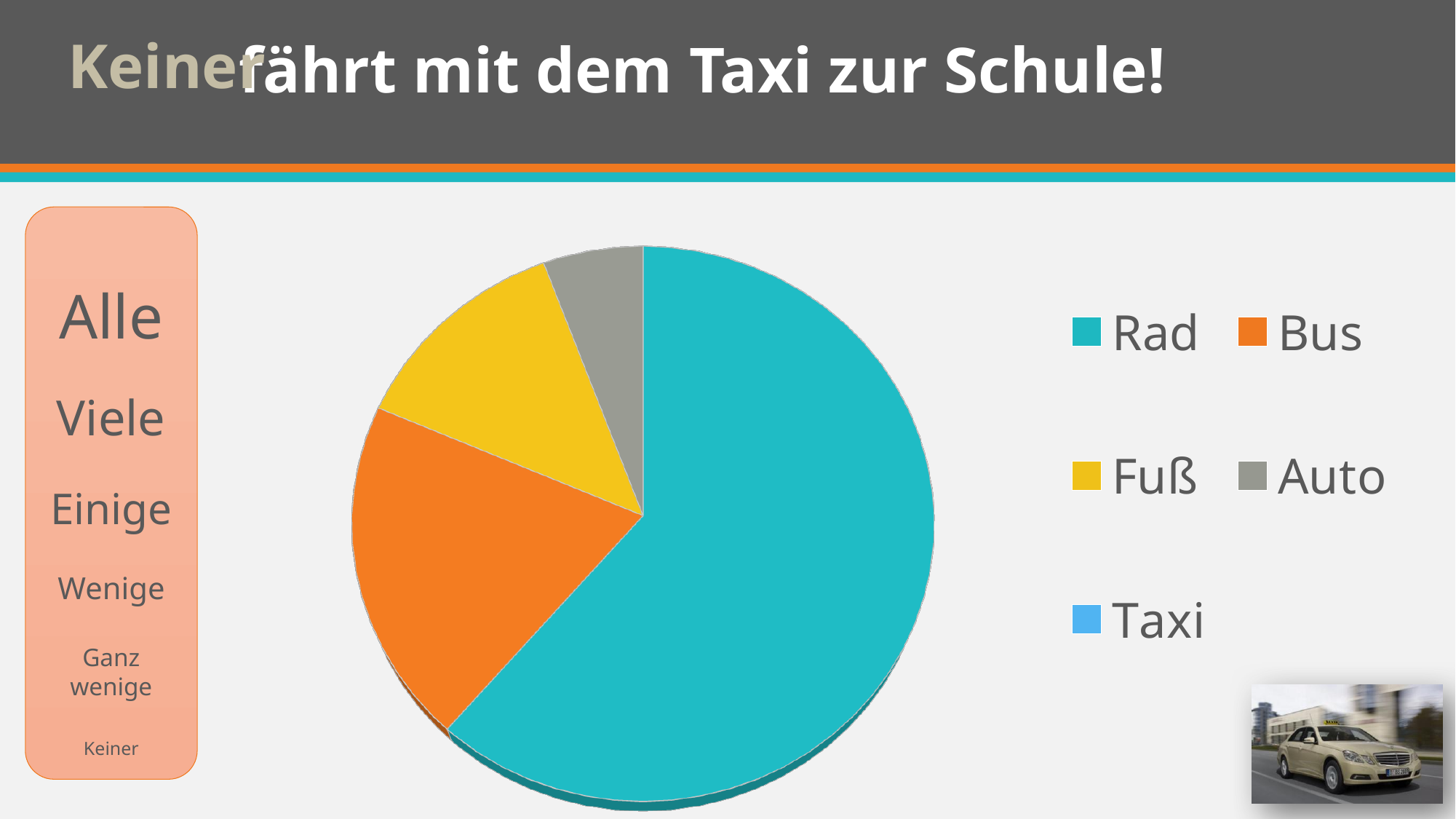
Does the Rad slice take up more or less than half of the pie? more Which slice is larger, Bus or Fuß? Bus Which slice is larger, Fuß or Auto? Fuß Which legend entry has no visible slice in the pie? Taxi Which category has the largest slice of the pie? Rad What colour is the Bus slice in the pie chart? orange Which of the visible slices of the pie is the smallest? Auto How many categories does the legend list? 5 How many slices are visible in the pie? 4 What kind of chart is shown on the slide? pie chart Which slice is larger, Rad or Bus? Rad Which legend entry is shown in grey? Auto